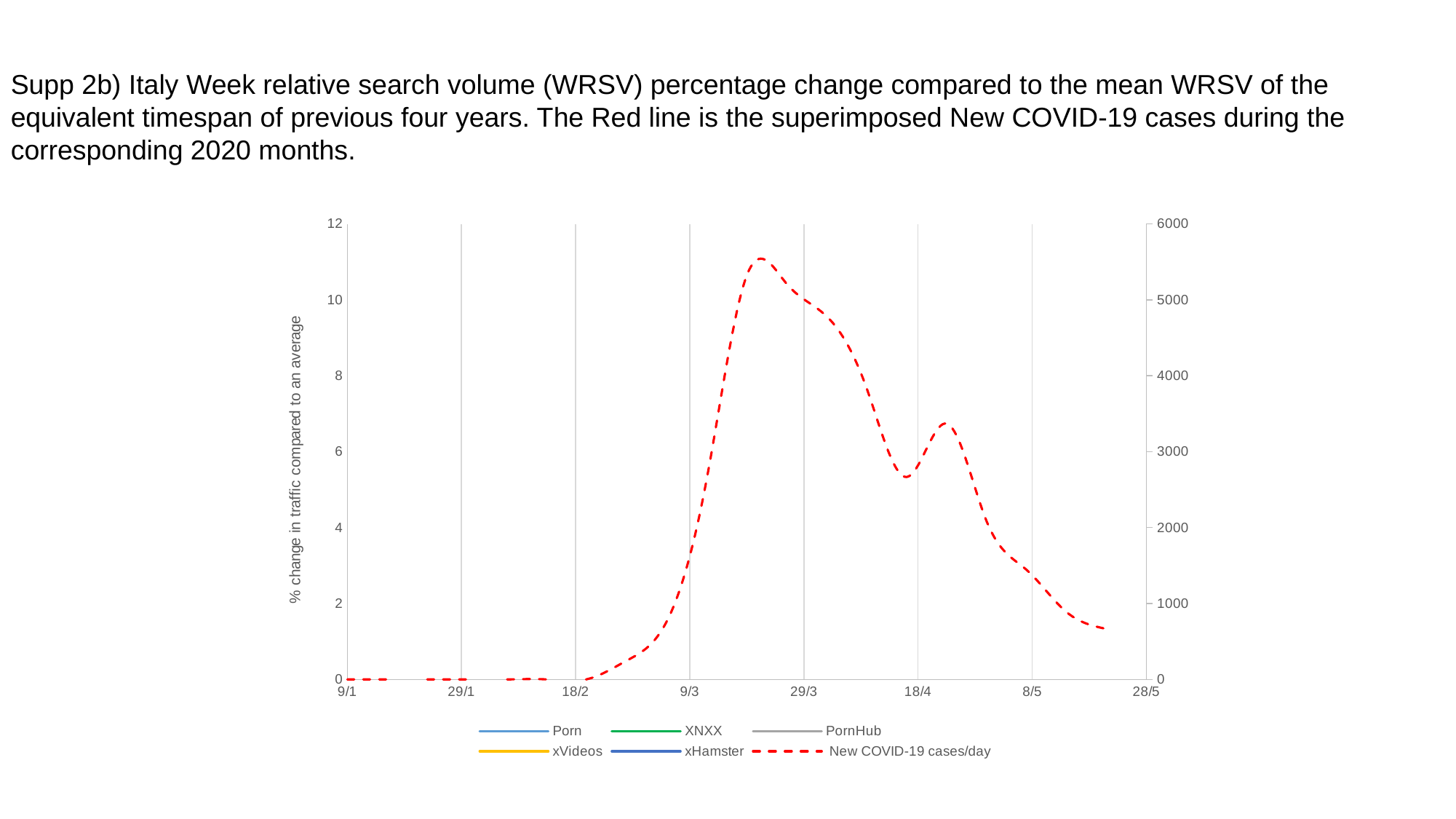
What kind of chart is shown on the slide? line chart Is the value of the New COVID-19 cases/day line at 9/3 greater or less than 2000 on the right axis? less Is the peak value of the New COVID-19 cases/day line greater or less than 5000 on the right axis? greater Does the New COVID-19 cases/day line rise or fall between 9/3 and 29/3? rise Does the New COVID-19 cases/day line rise or fall between 29/3 and 18/4? fall How many series does the legend list? 6 Which is larger for the New COVID-19 cases/day line: the value at 29/3 or the value at 8/5? 29/3 Which series is drawn as a red dashed line? New COVID-19 cases/day Is the value of the New COVID-19 cases/day line at 8/5 greater or less than 2000 on the right axis? less What is the title of the left vertical axis? % change in traffic compared to an average